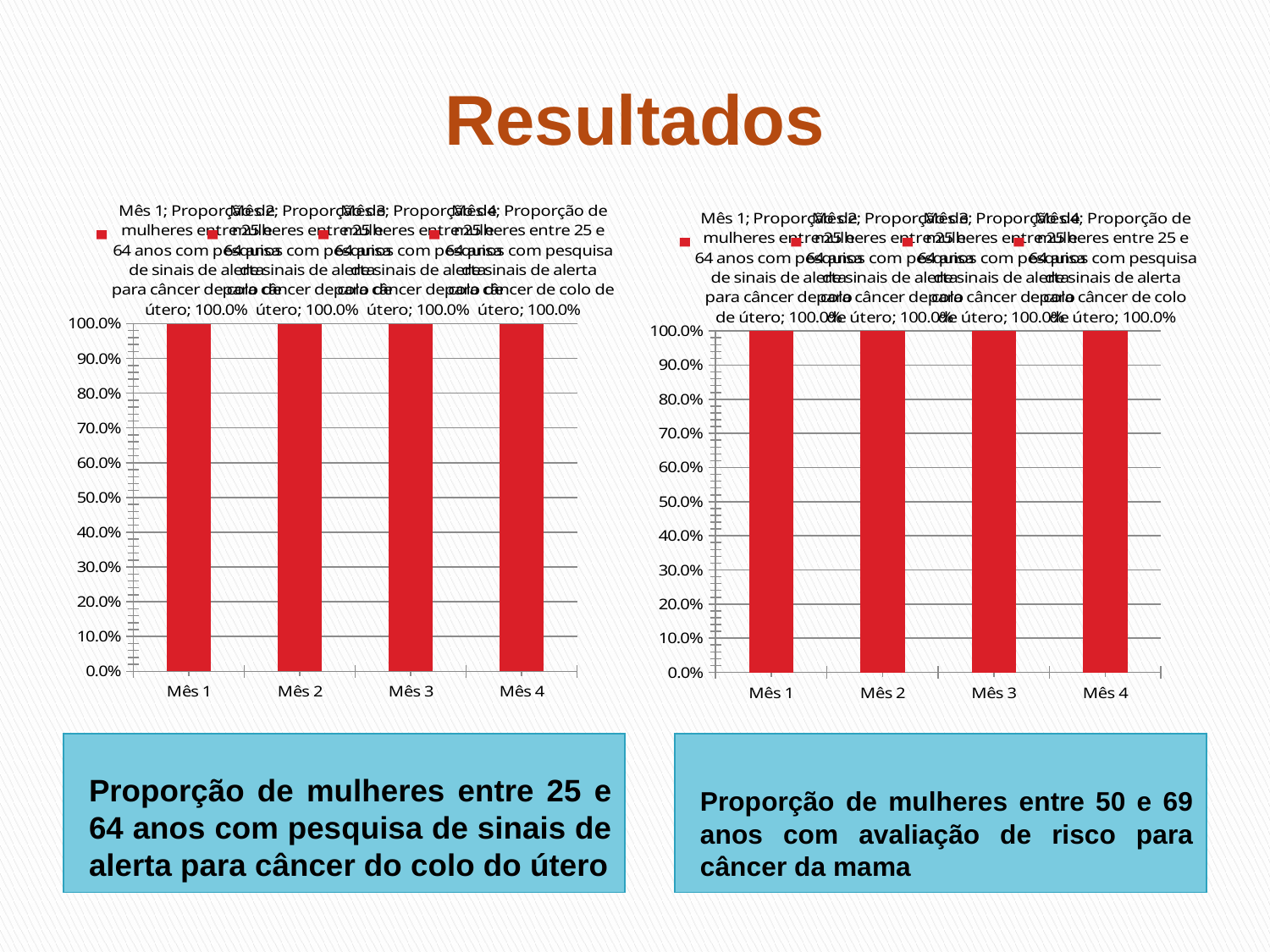
How many categories (months) are shown on the left chart? 4 On the left chart (Proporção de mulheres entre 25 e 64 anos), what is the value for Mês 4? 100.0% What is the title of the slide? Resultados How many bars are plotted on the right chart? 4 On the left chart (Proporção de mulheres entre 25 e 64 anos), what is the value for Mês 1? 100.0% On the right chart, is the value for Mês 4 greater or less than 90.0%? greater On the right chart (Proporção de mulheres entre 50 e 69 anos), what is the value for Mês 2? 100.0% On the left chart, what is the difference between the values for Mês 1 and Mês 3? 0.0% On the right chart, do the values rise, fall or stay the same from Mês 1 to Mês 4? Stay the same On the right chart (Proporção de mulheres entre 50 e 69 anos), what is the value for Mês 3? 100.0% According to the caption below the right chart, what does the right chart measure? Proporção de mulheres entre 50 e 69 anos com avaliação de risco para câncer da mama What kind of chart is the left chart? Bar chart